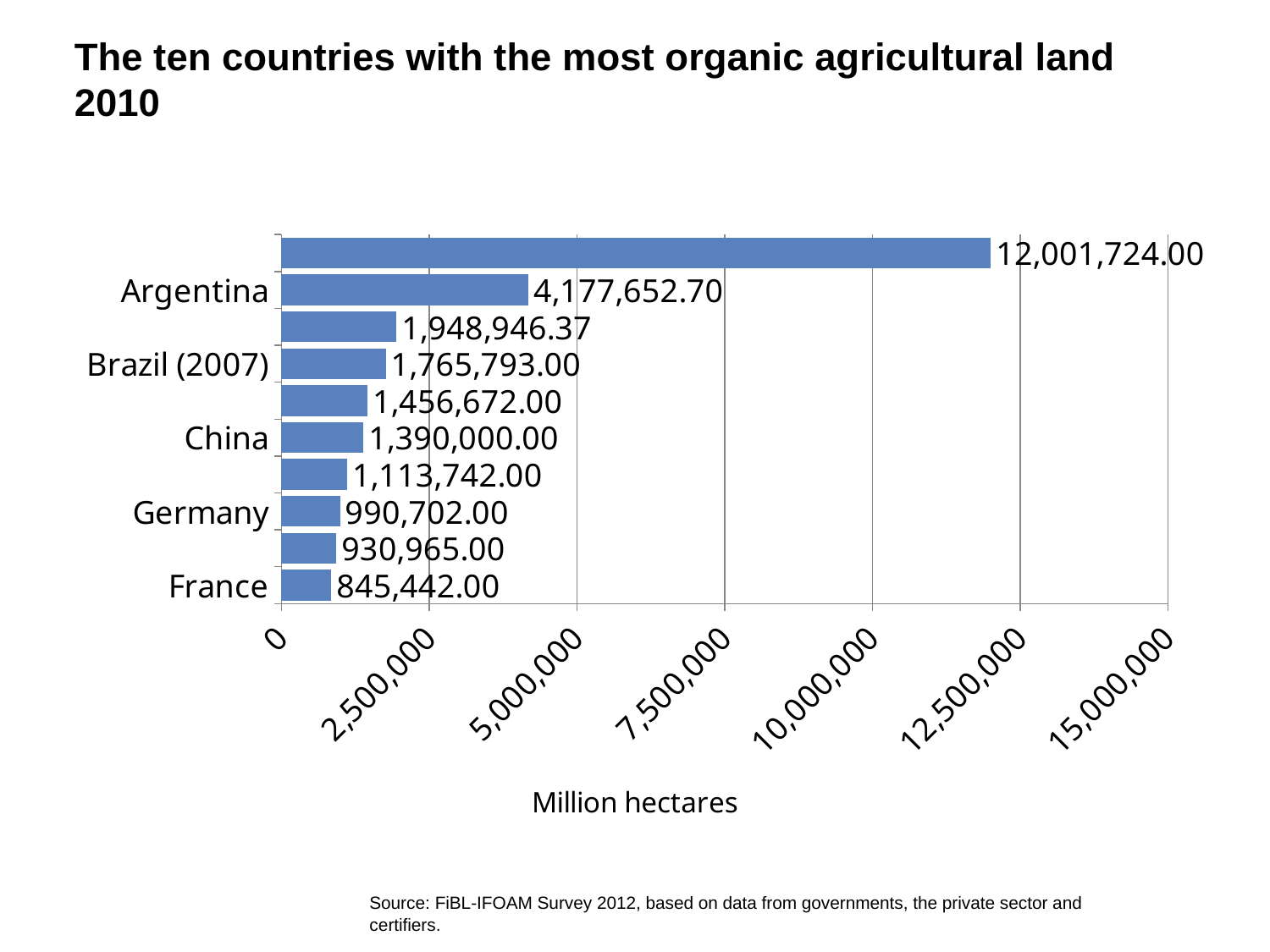
What is the title of the horizontal axis? Million hectares How many bars are plotted in the chart? 10 Which has a larger value, Argentina or Brazil (2007)? Argentina What is the value shown for Germany? 990,702.00 What is the value shown for Argentina? 4,177,652.70 What is the value shown for Brazil (2007)? 1,765,793.00 Which country has the lowest value in the chart? France What is the value shown for China? 1,390,000.00 What kind of chart is shown on the slide? Bar chart What is the value printed on the longest bar in the chart? 12,001,724.00 What is the difference between the values for Germany and France? 145,260.00 What is the value shown for France? 845,442.00